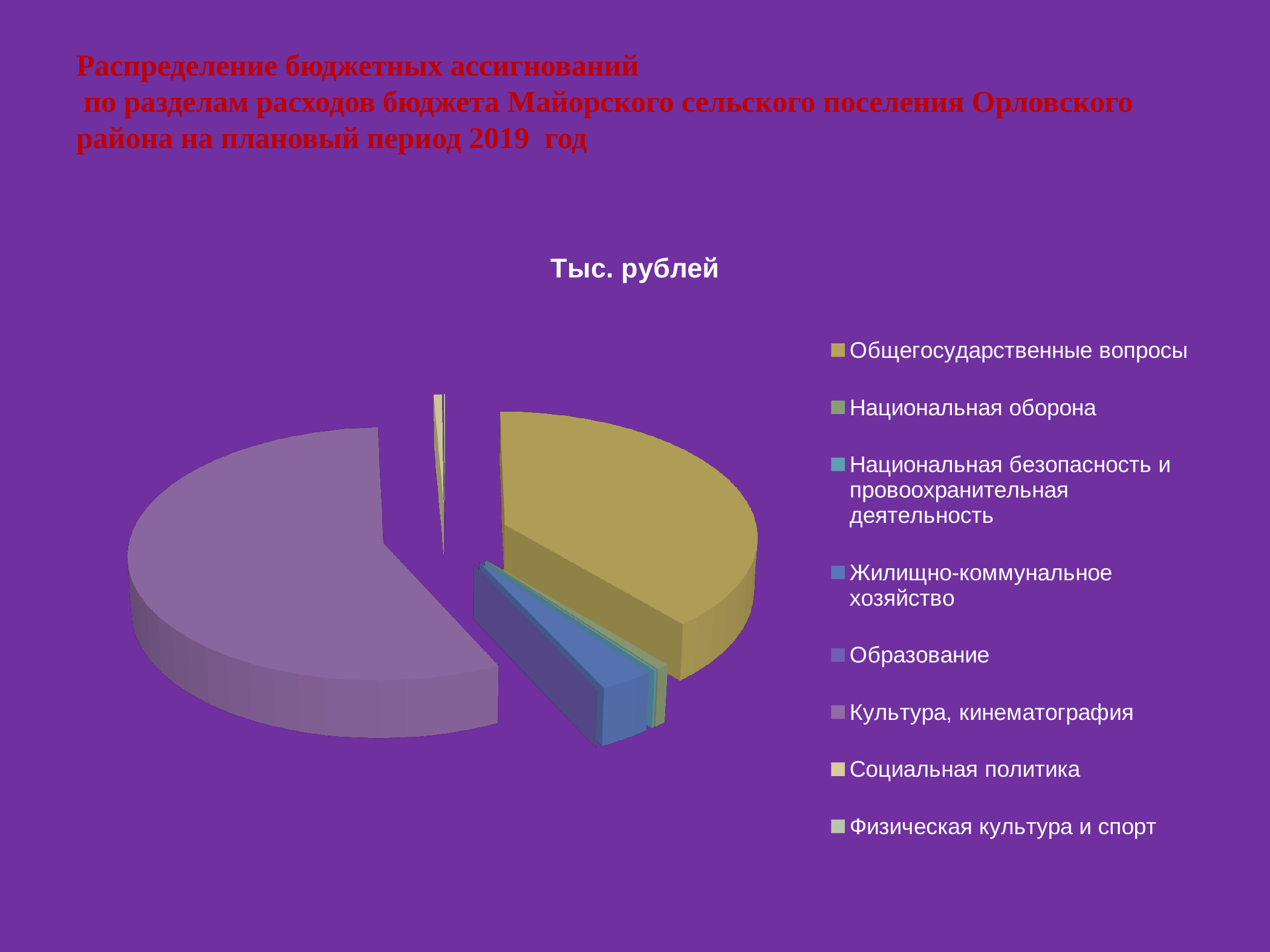
Which category has the largest slice of the pie? Культура, кинематография What is the first entry listed in the chart legend? Общегосударственные вопросы What is the title of the chart? Тыс. рублей Which is larger: the slice for Общегосударственные вопросы or the slice for Жилищно-коммунальное хозяйство? Общегосударственные вопросы What kind of chart is shown on the slide? pie chart How many entries does the chart legend list? 8 Which is larger: the slice for Жилищно-коммунальное хозяйство or the slice for Социальная политика? Жилищно-коммунальное хозяйство Which is larger: the slice for Культура, кинематография or the slice for Общегосударственные вопросы? Культура, кинематография How many categories are shown in the pie chart? 8